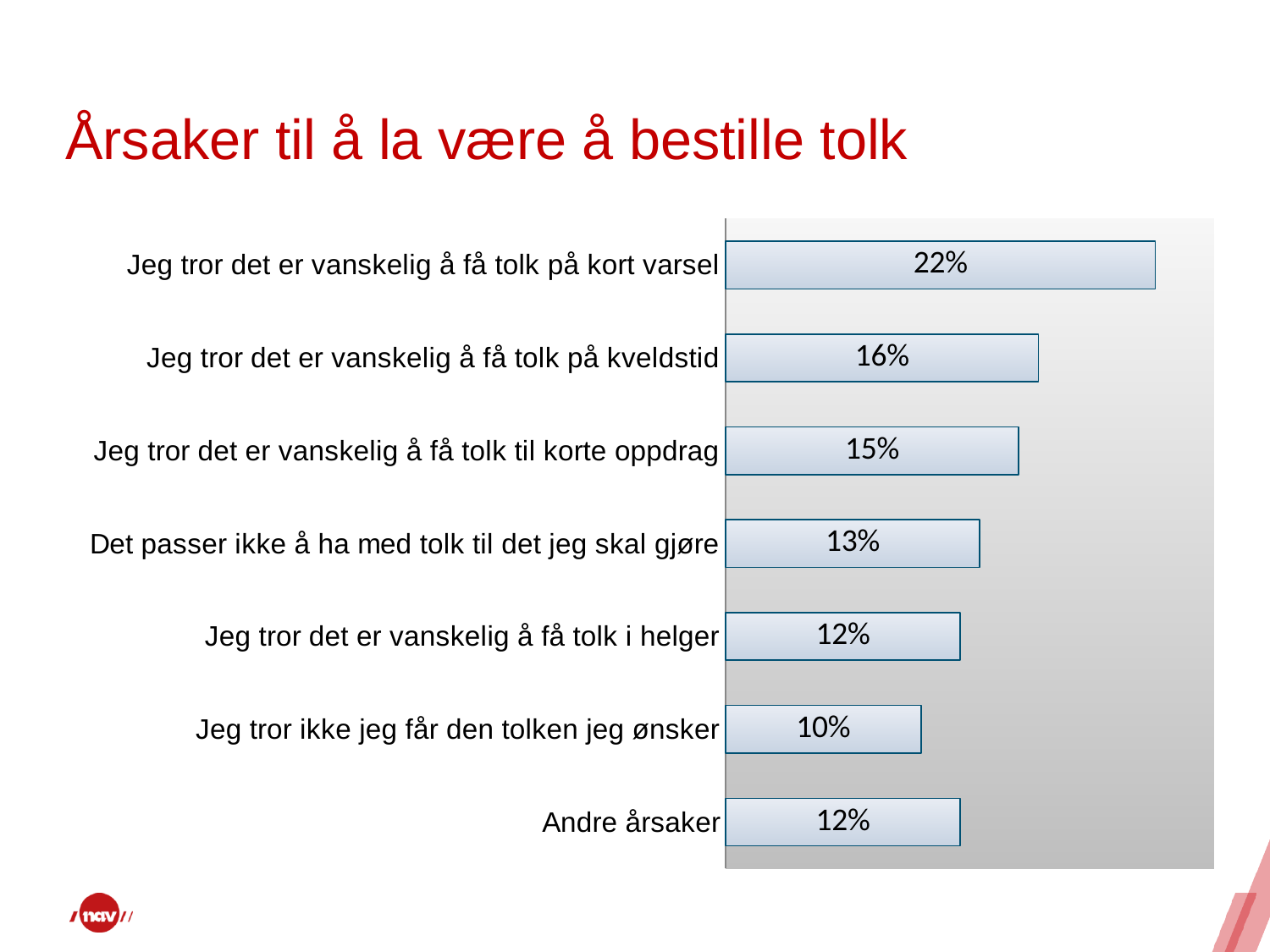
How many categories are shown in the chart? 7 What is the title of the slide? Årsaker til å la være å bestille tolk What is the value for "Andre årsaker"? 12% What kind of chart is shown on the slide? Bar chart What is the value for "Jeg tror det er vanskelig å få tolk på kort varsel"? 22% What is the value for "Det passer ikke å ha med tolk til det jeg skal gjøre"? 13% Which category has the lowest value? Jeg tror ikke jeg får den tolken jeg ønsker Which is larger: the value for "Jeg tror det er vanskelig å få tolk på kveldstid" or for "Jeg tror det er vanskelig å få tolk i helger"? Jeg tror det er vanskelig å få tolk på kveldstid What is the difference between the values for "Jeg tror det er vanskelig å få tolk til korte oppdrag" and "Jeg tror ikke jeg får den tolken jeg ønsker"? 5% Which category has the highest value? Jeg tror det er vanskelig å få tolk på kort varsel What is the difference between the values for "Jeg tror det er vanskelig å få tolk på kort varsel" and "Jeg tror det er vanskelig å få tolk på kveldstid"? 6% What is the value for "Jeg tror det er vanskelig å få tolk på kveldstid"? 16%